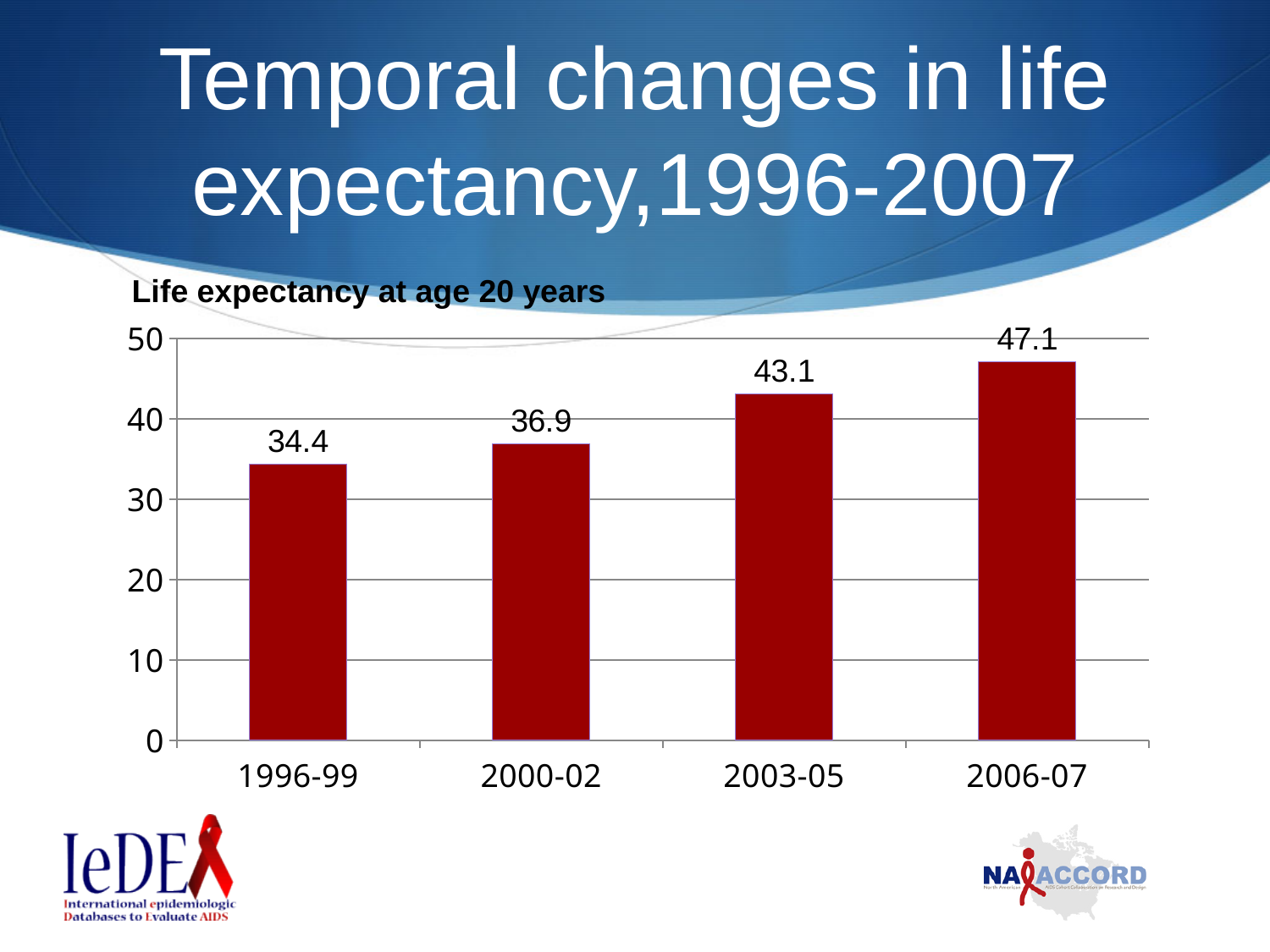
Which period has the lowest life expectancy at age 20 years? 1996-99 What is the life expectancy at age 20 years for 1996-99? 34.4 How many time periods are shown on the x axis? 4 Which period has the highest life expectancy at age 20 years? 2006-07 Do the values rise or fall from 1996-99 to 2006-07? rise Is the value for 2000-02 greater or less than 40? less Which is larger, the value for 2000-02 or the value for 2003-05? 2003-05 What kind of chart is shown on the slide? bar chart What is the difference between the values for 2006-07 and 1996-99? 12.7 What is the life expectancy at age 20 years for 2003-05? 43.1 What is the difference between the values for 2003-05 and 2000-02? 6.2 What is the value shown for 2006-07? 47.1